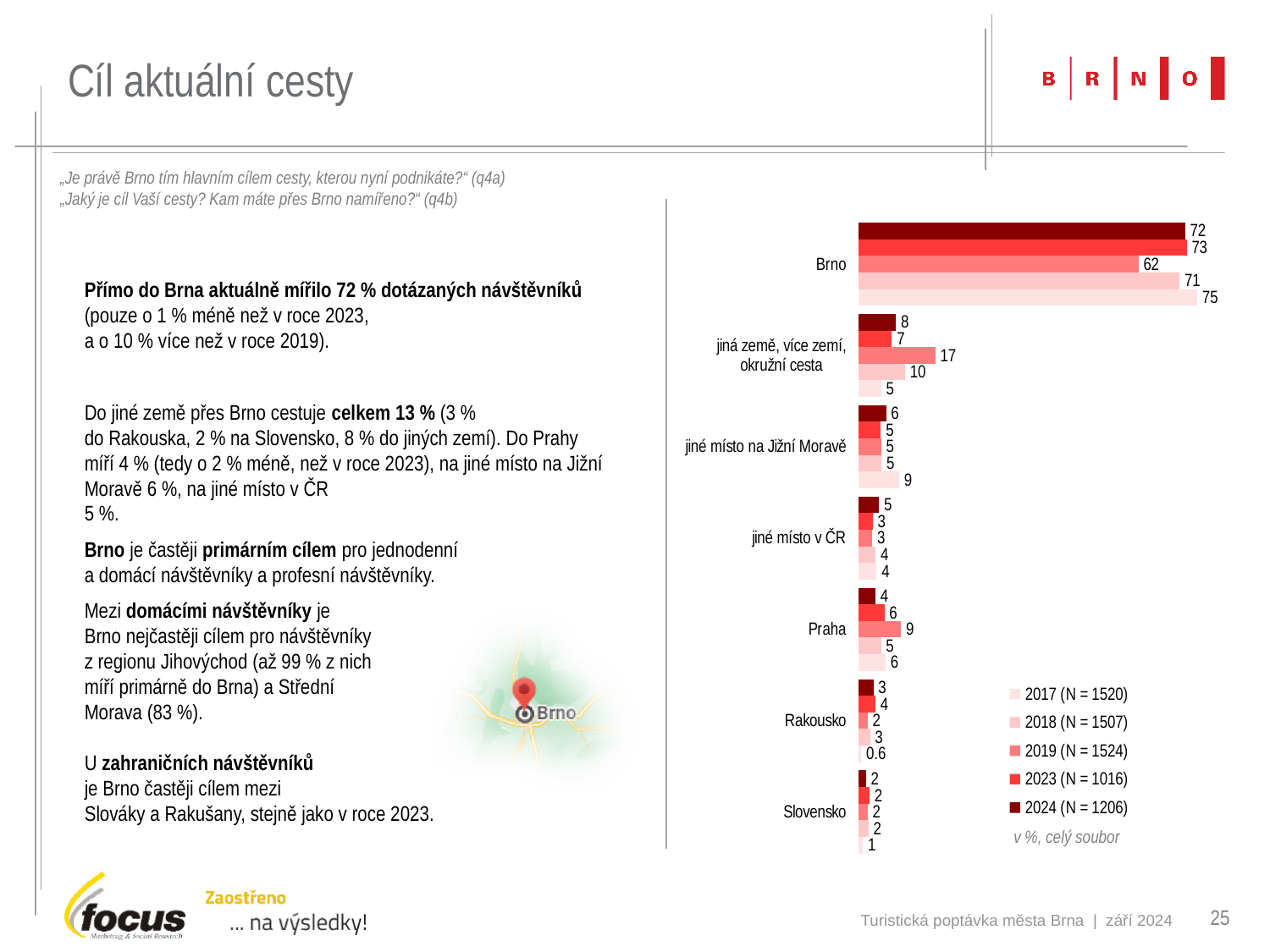
Which category has the lowest value in the 2017 series? Rakousko What is the value for Rakousko in the 2017 series? 0.6 How many categories are shown on the chart? 7 How many series does the chart legend list? 5 What is the difference between the Brno values for 2023 and 2024? 1 Which category has the highest value in the 2024 series? Brno What type of chart is shown on the slide? bar chart What is the value for Brno in the 2019 series? 62 Which is larger: the 2019 value for Praha or the 2019 value for Rakousko? Praha What is the value for 'jiná země, více zemí, okružní cesta' in the 2019 series? 17 What sample size (N) does the legend give for the 2024 series? N = 1206 What is the value for Brno in the 2024 series? 72